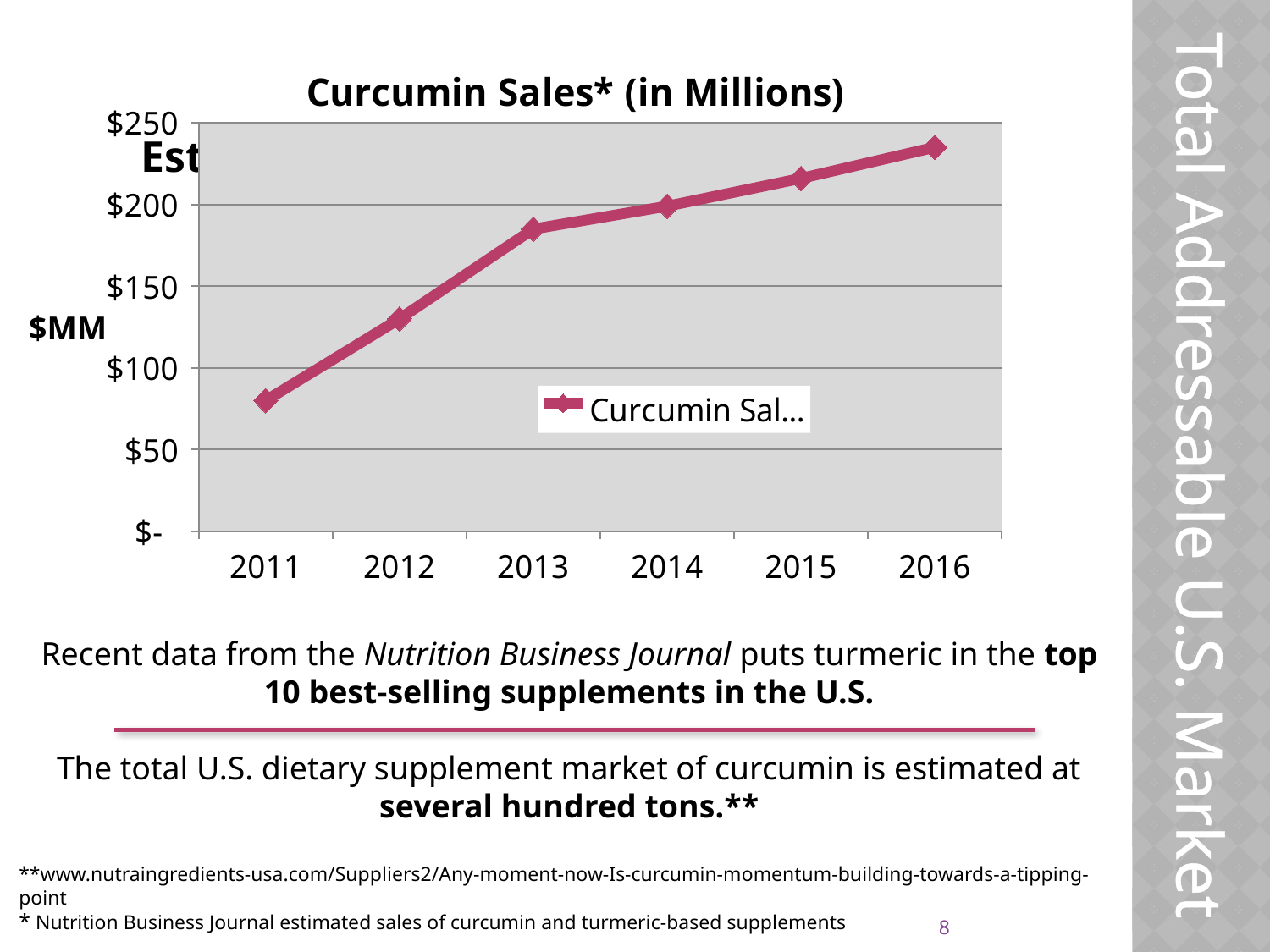
Do curcumin sales rise or fall from 2011 to 2016? rise Is the value for 2016 greater or less than $200? greater How many series does the chart's legend list? 1 How many years are plotted on the x axis of the chart? 6 Which year has the lowest curcumin sales value? 2011 What is the title of the chart? Curcumin Sales* (in Millions) Which year has the larger curcumin sales value, 2012 or 2013? 2013 Is the value for 2011 greater or less than $100? less Is the value for 2013 greater or less than $150? greater What kind of chart is shown on the slide? line chart Which year has the highest curcumin sales value? 2016